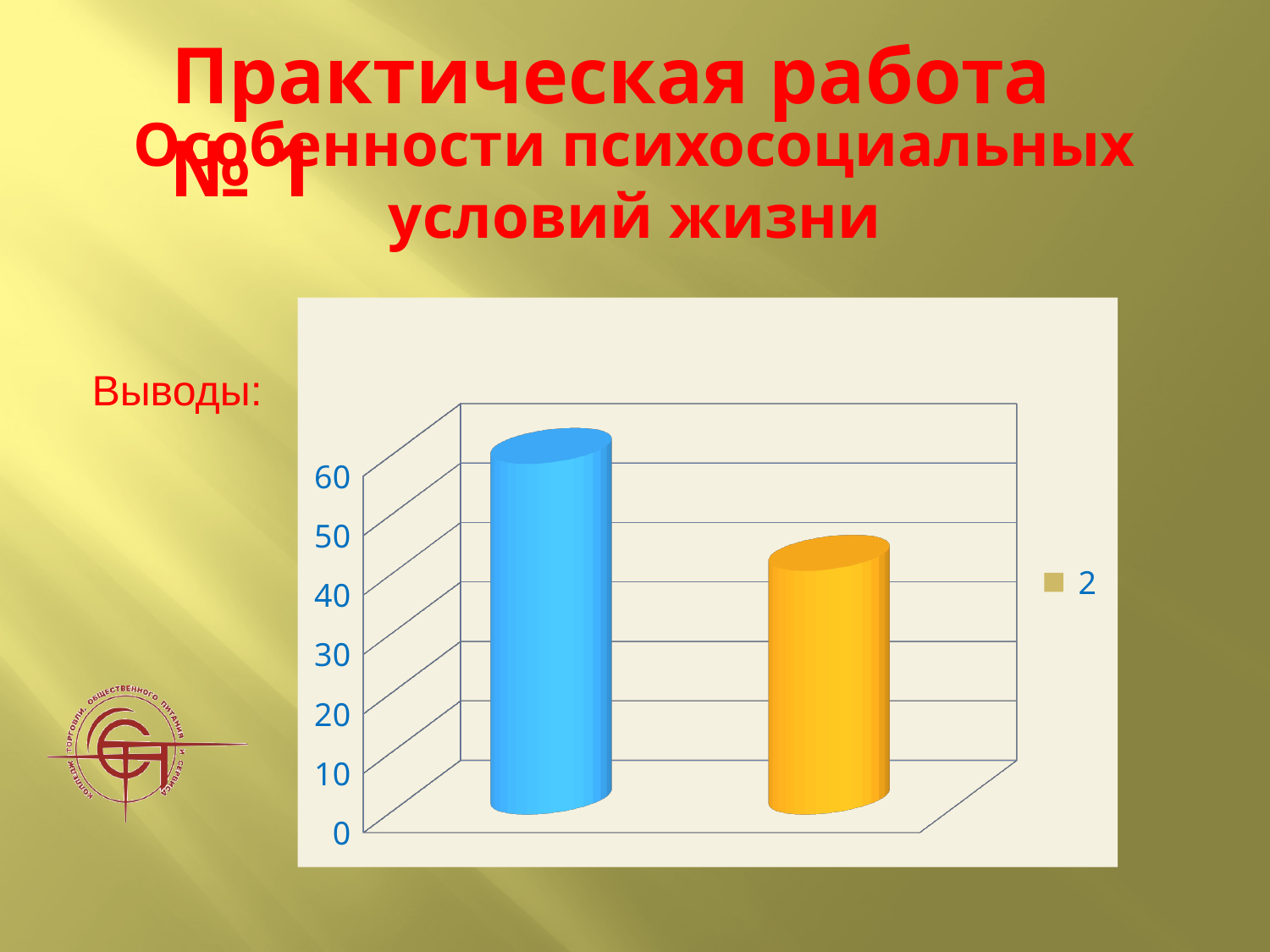
Which bar has the lowest value in the chart? the orange bar on the right Is the value of the orange bar on the right greater or less than 50? less What is the legend entry shown to the right of the chart? 2 Which bar is taller, the blue bar on the left or the orange bar on the right? the blue bar on the left What is the highest value shown on the vertical axis of the chart? 60 What kind of chart is shown on the slide? bar chart How many series does the chart legend list? 1 How many bars are plotted in the chart? 2 Is the value of the blue bar on the left greater or less than 50? greater Do the bar values rise or fall from left to right across the chart? fall Is the value of the orange bar on the right greater or less than 30? greater